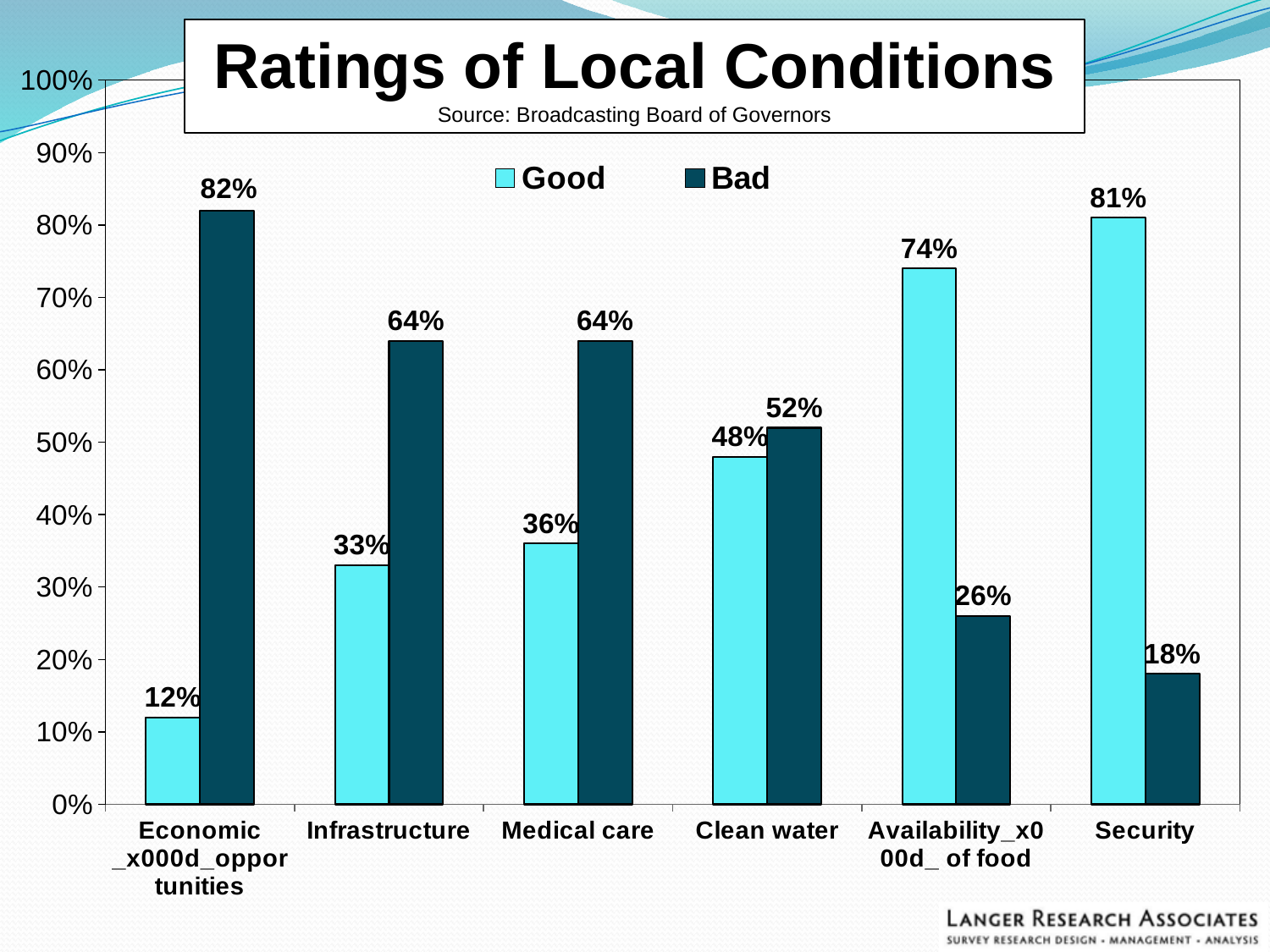
Which category has the highest Bad rating? Economic opportunities What is the Good rating for Infrastructure? 33% Which is larger for Availability of food, the Good rating or the Bad rating? Good What kind of chart is shown on the slide? Bar chart What is the Good rating for Security? 81% What source is cited for the chart? Broadcasting Board of Governors What is the Bad rating for Clean water? 52% What is the difference between the Bad and Good ratings for Clean water? 4% What is the Bad rating for Medical care? 64% Which category has the lowest Good rating? Economic opportunities How many categories are shown on the x axis? 6 How many series does the legend list? 2